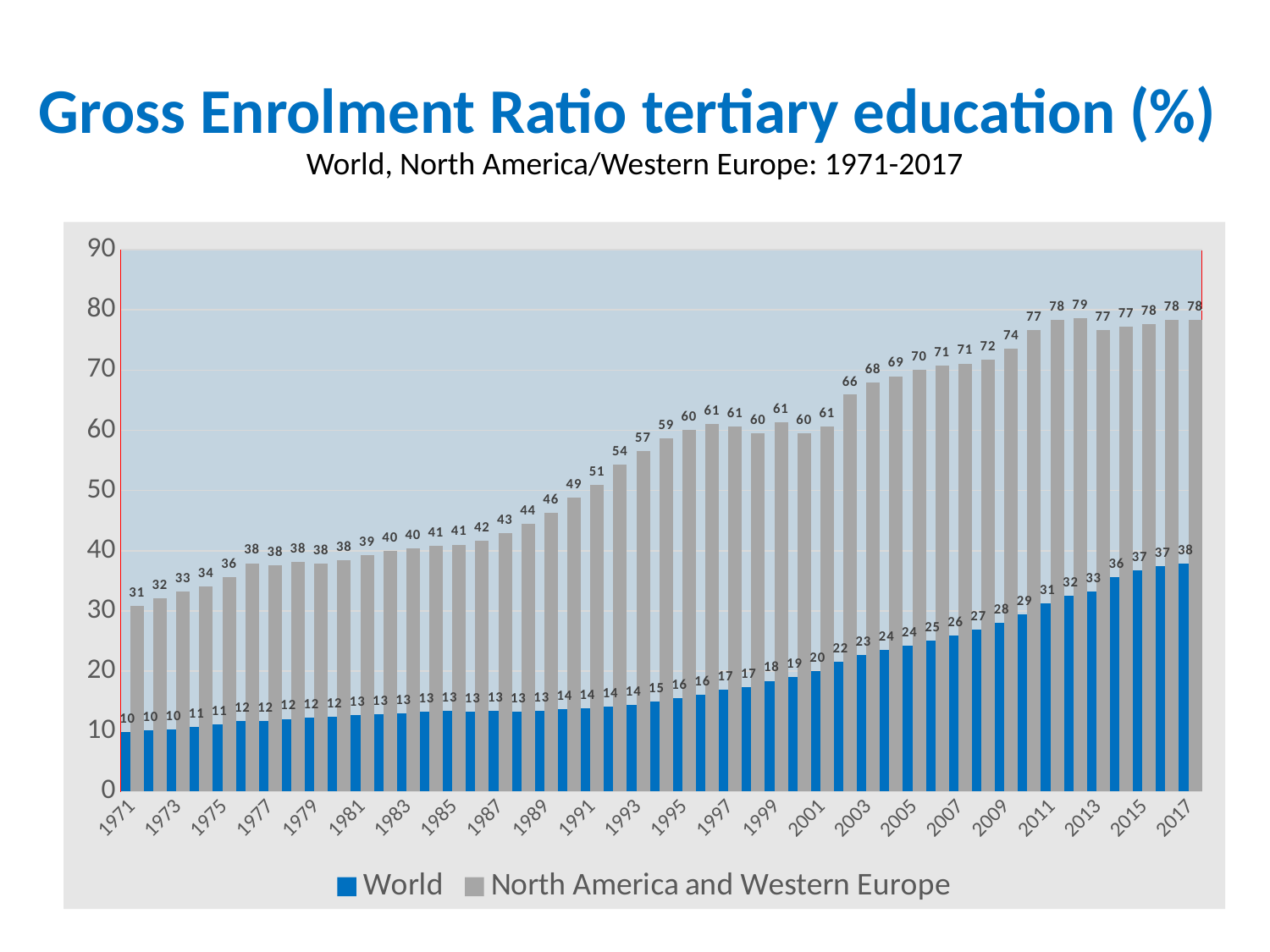
What is the World value for 2017? 38 What is the lowest value shown for the World series? 10 What is the value for North America and Western Europe in 1971? 31 What kind of chart is shown on the slide? Bar chart What is the highest value shown for the World series? 38 Do the World values rise or fall from 1971 to 2017? Rise In which year does North America and Western Europe reach its highest value? 2012 Which is larger in 1995: the World value or the North America and Western Europe value? North America and Western Europe How many series does the legend list? 2 What is the difference between the North America and Western Europe value and the World value in 2017? 40 What is the title of the chart on the slide? Gross Enrolment Ratio tertiary education (%) What is the World value for 2001? 20